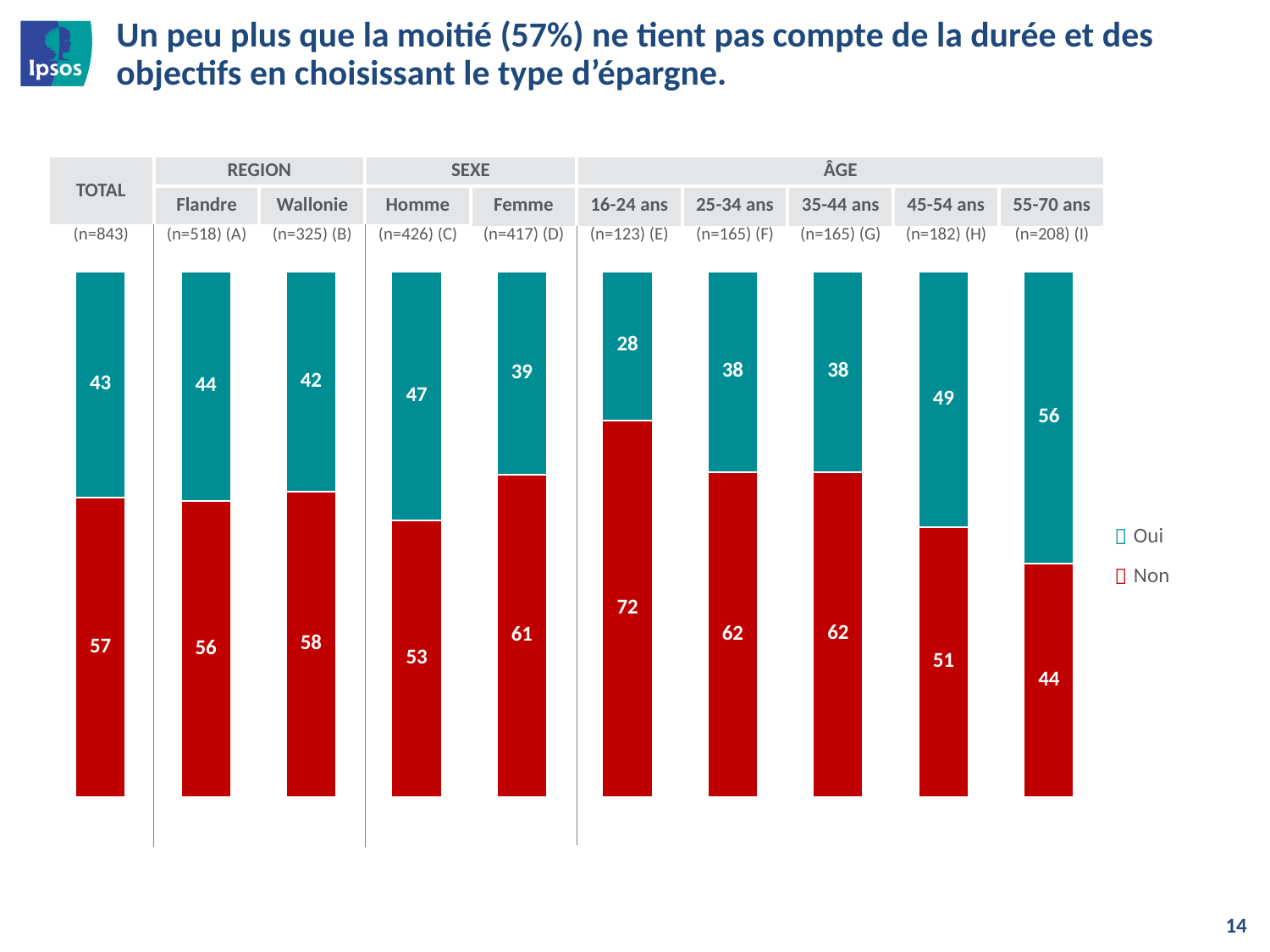
What is the 'Non' value for the TOTAL bar? 57 What kind of chart is shown on the slide? Stacked bar chart Which category has the highest 'Oui' value? 55-70 ans What is the 'Oui' value for the 16-24 ans group? 28 Which category has the lowest 'Oui' value? 16-24 ans What is the total of the stacked bar for 45-54 ans? 100 How many categories (bars) are shown in the chart? 10 What is the 'Non' value for Femme? 61 How many series does the legend list? 2 Which colour represents 'Non' in the chart? Red Which has a larger 'Oui' value, Homme or Femme? Homme What is the difference between the 'Non' values for Wallonie and Flandre? 2